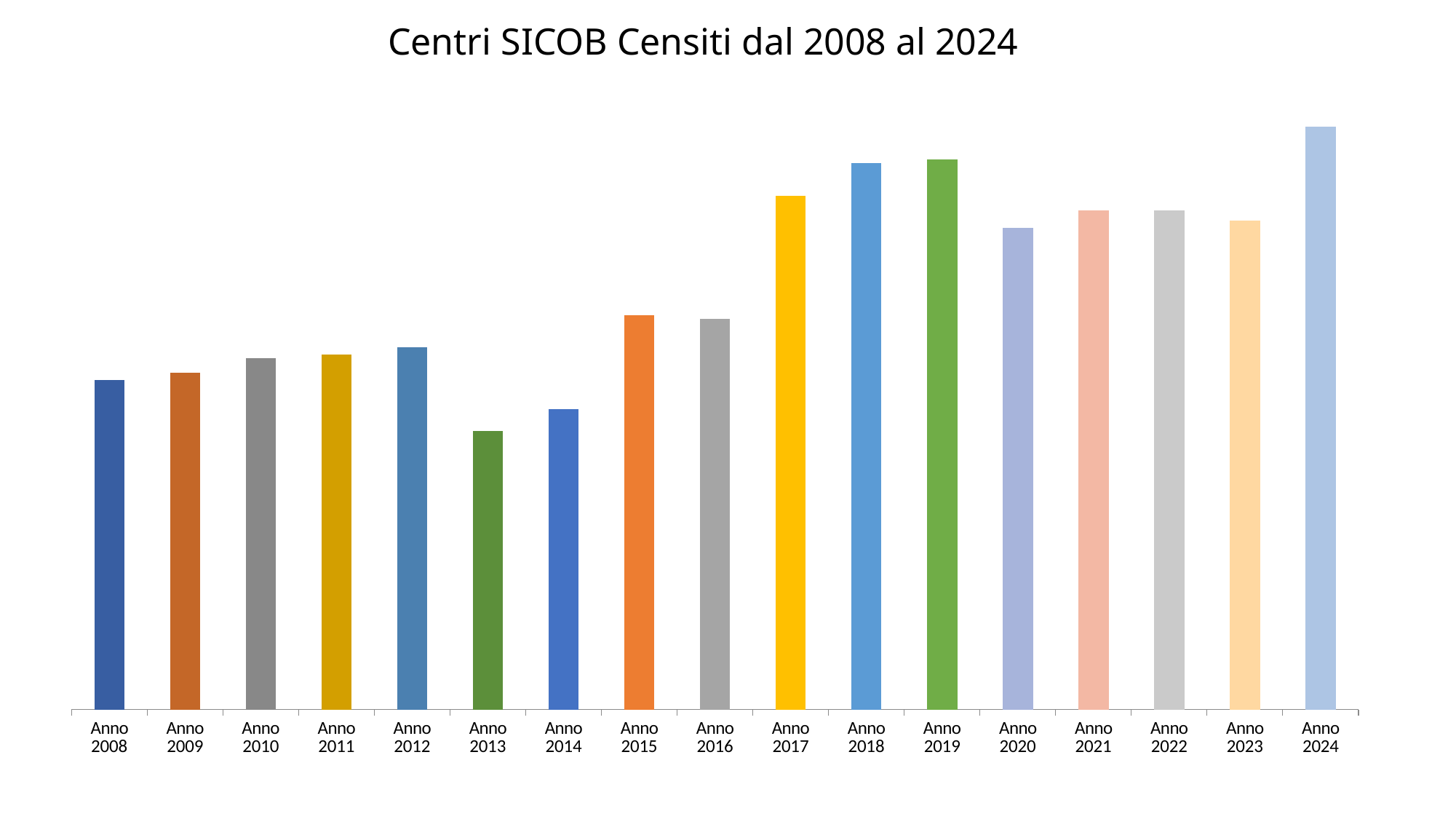
What is the title of the chart? Centri SICOB Censiti dal 2008 al 2024 Which is larger, the value for Anno 2012 or Anno 2015? Anno 2015 Which is larger, the value for Anno 2019 or Anno 2024? Anno 2024 Which is larger, the value for Anno 2013 or Anno 2014? Anno 2014 What kind of chart is shown on the slide? bar chart Overall, do the values rise or fall from Anno 2008 to Anno 2024? rise Which year has the highest bar? Anno 2024 Which year has the lowest bar? Anno 2013 Do the values rise or fall from Anno 2019 to Anno 2020? fall How many years (categories) are shown on the x axis? 17